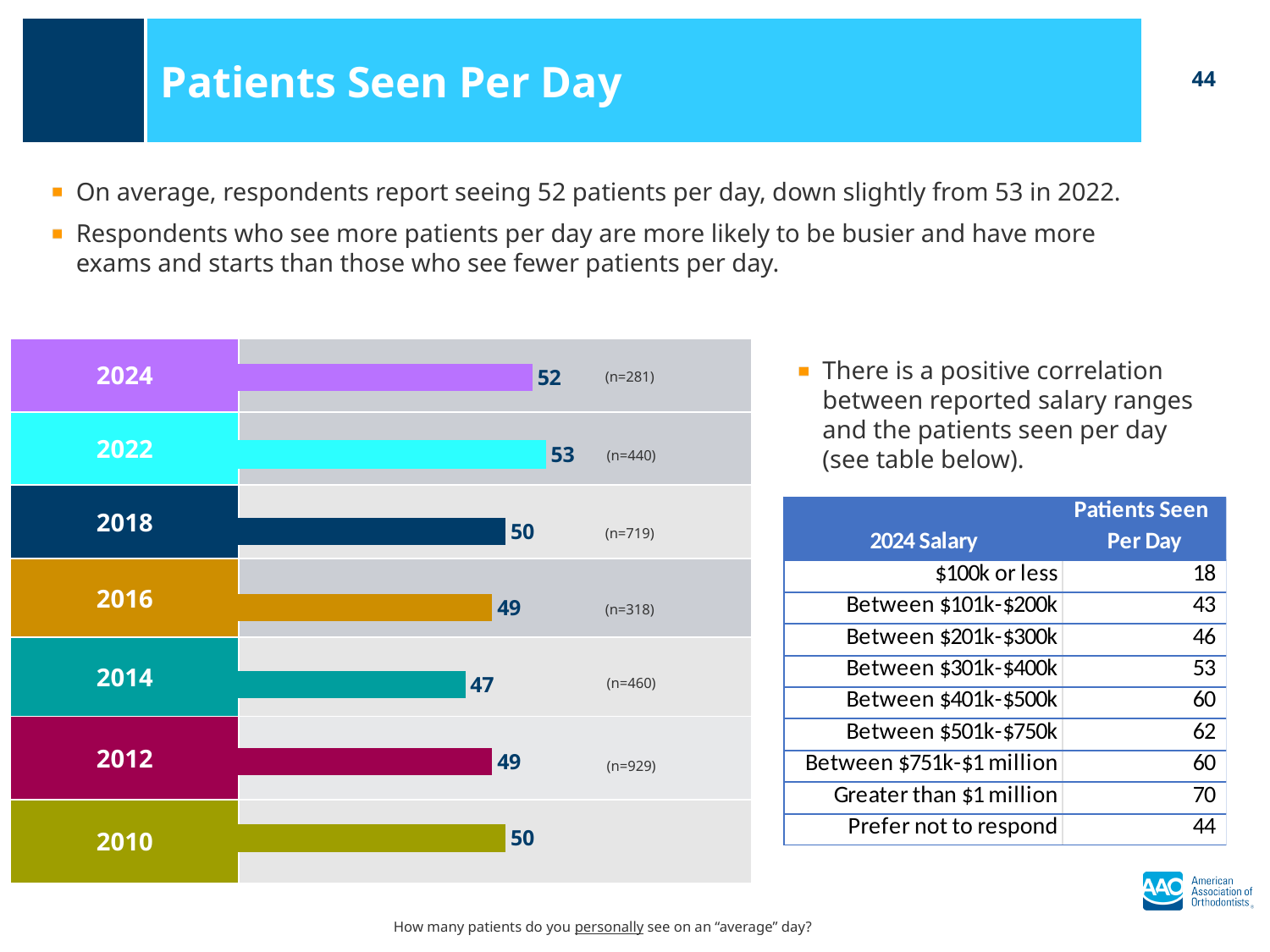
What is the average number of patients seen per day reported for 2024? 52 What is the value shown for 2014 in the bar chart? 47 What is the sample size (n) shown next to the 2012 bar? 929 Did the value rise or fall from 2022 to 2024? fall What is the difference between the values for 2022 and 2024? 1 What kind of chart is used to show patients seen per day by year? bar chart Which year has the lowest value in the bar chart? 2014 Which is larger, the value for 2016 or the value for 2014? 2016 How many years are shown in the bar chart? 7 What is the difference between the values for 2018 and 2014? 3 Which year has the highest value in the bar chart? 2022 What is the value shown for 2010 in the bar chart? 50